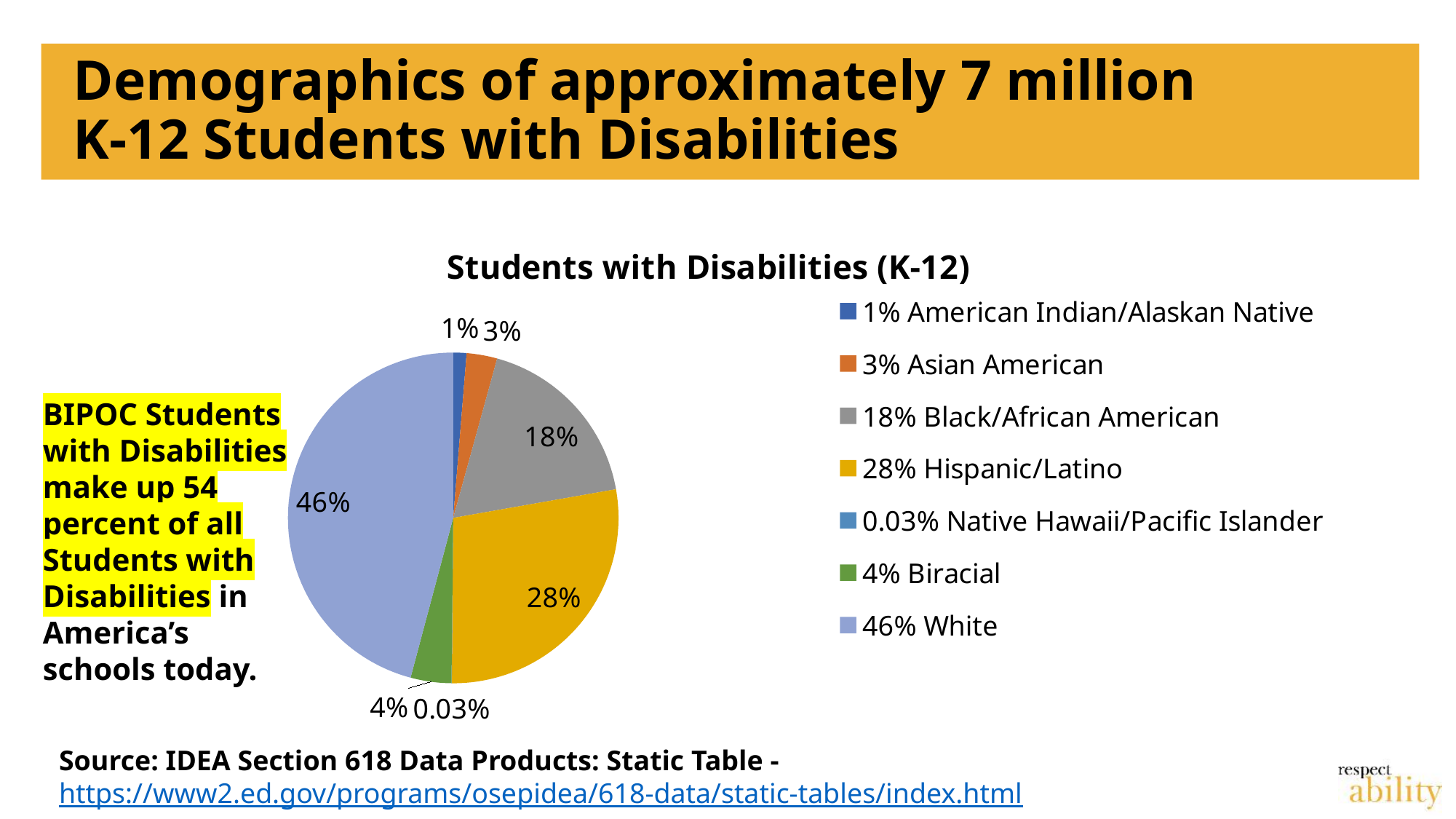
What type of chart is shown on the slide? pie chart How many categories does the legend list? 7 Which group has the largest share of the pie? White What percentage of students with disabilities are Hispanic/Latino? 28% What percentage of students with disabilities are Black/African American? 18% Which group has the smallest share of the pie? Native Hawaii/Pacific Islander Which is larger, the Asian American share or the Biracial share? Biracial What is the chart's title? Students with Disabilities (K-12) What is the difference between the White share and the Hispanic/Latino share? 18% What colour is the slice for Hispanic/Latino? gold/yellow What percentage of students with disabilities are Biracial? 4% What percentage of students with disabilities are Native Hawaii/Pacific Islander? 0.03%